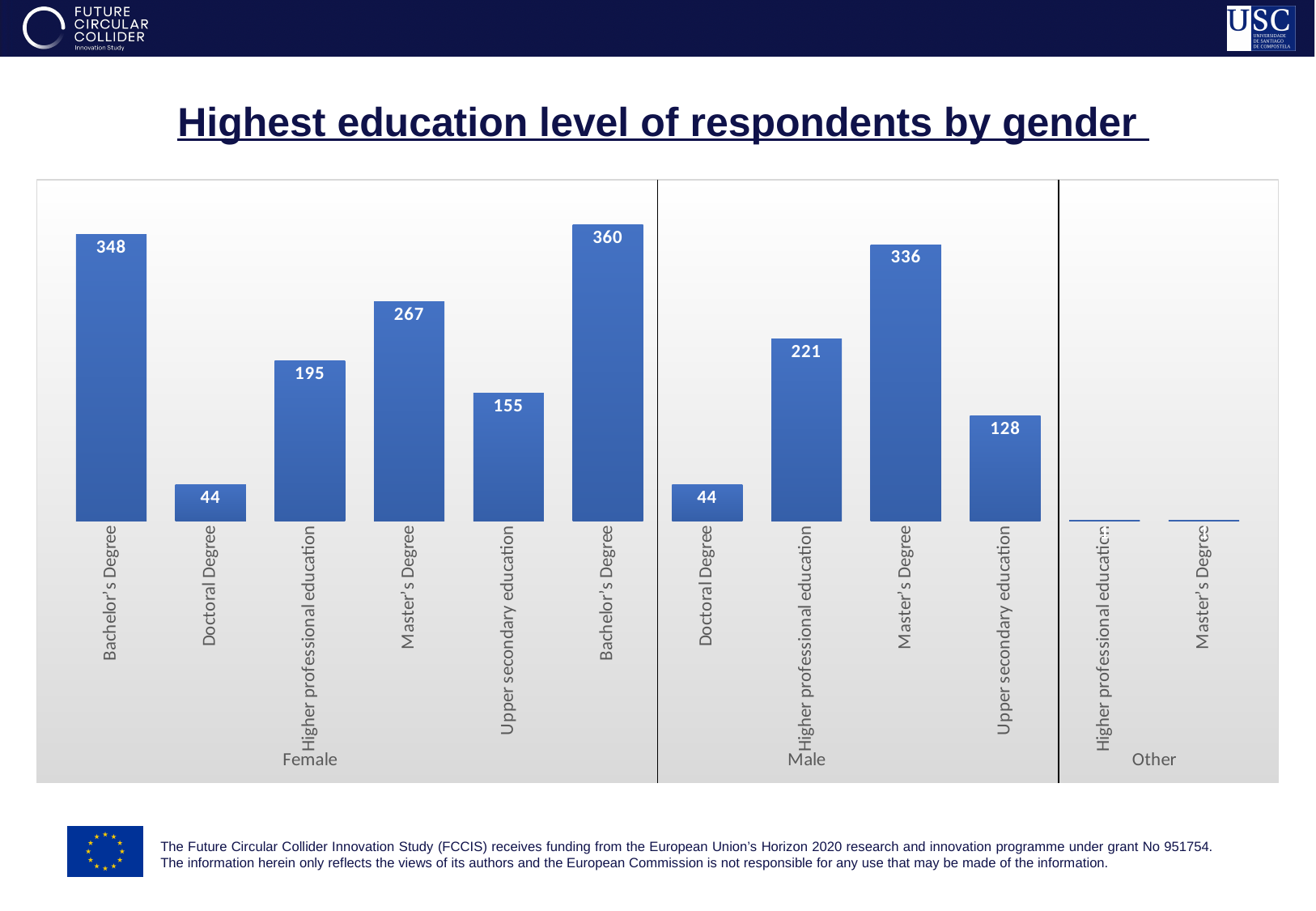
Which education level has the lowest value among Female respondents? Doctoral Degree Which education level has the highest value among Male respondents? Bachelor's Degree What is the value for Bachelor's Degree among Female respondents? 348 What kind of chart is shown on the slide? Bar chart What is the value for Higher professional education among Female respondents? 195 What is the value for Upper secondary education among Male respondents? 128 What is the difference between the Female values for Bachelor's Degree and Upper secondary education? 193 Which is larger: the Female value for Upper secondary education or the Male value for Upper secondary education? Female What is the title of the chart on the slide? Highest education level of respondents by gender How many gender groups are shown along the x axis? 3 What is the value for Master's Degree among Male respondents? 336 What is the difference between the Male and Female values for Master's Degree? 69